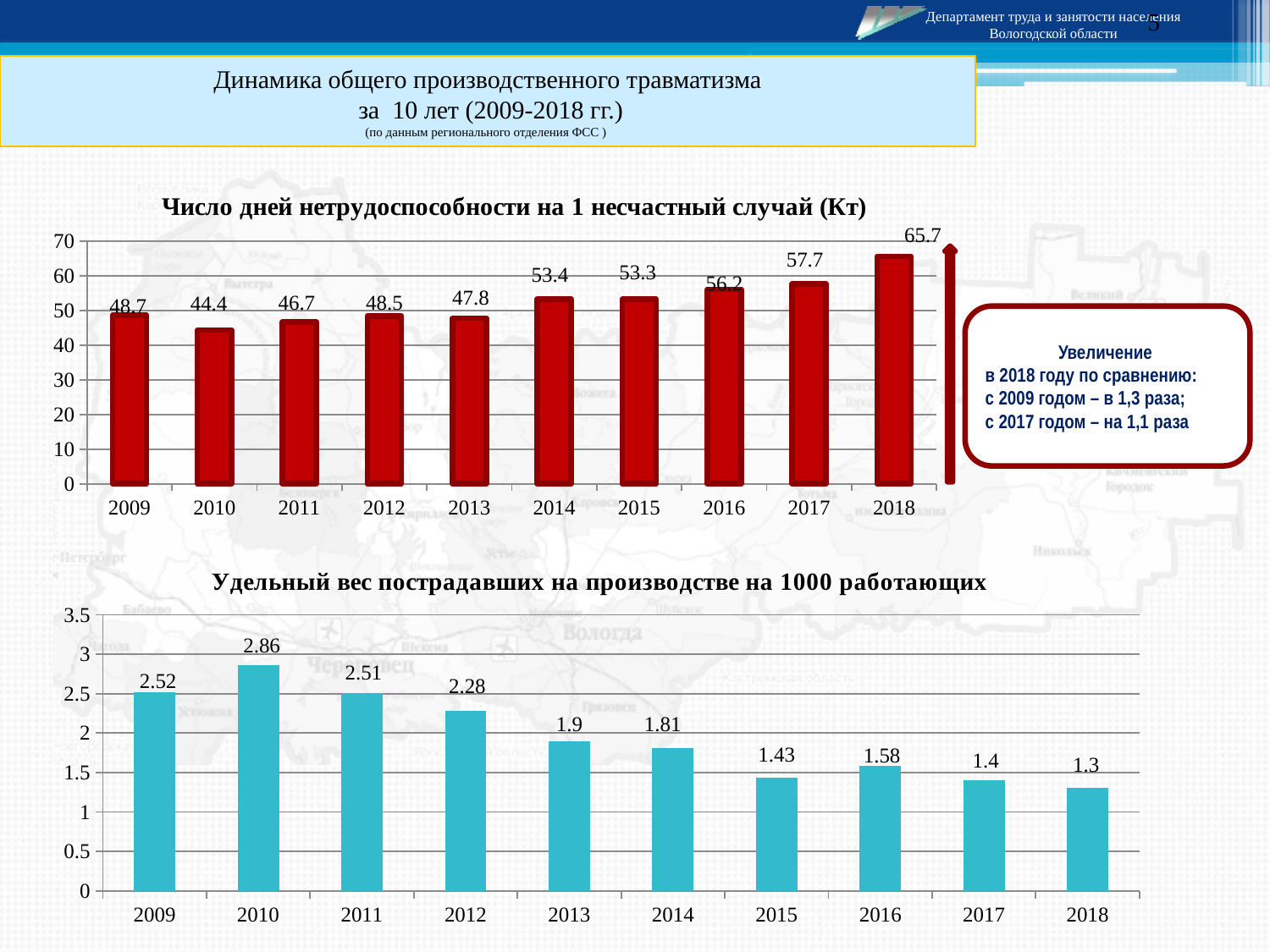
In the top chart (Число дней нетрудоспособности на 1 несчастный случай), what is the value for 2013? 47.8 In the bottom chart (Удельный вес пострадавших на производстве на 1000 работающих), what is the value for 2010? 2.86 In the top chart (Число дней нетрудоспособности на 1 несчастный случай), which year has the highest value? 2018 In the bottom chart (Удельный вес пострадавших на производстве на 1000 работающих), what is the value for 2015? 1.43 In the bottom chart (Удельный вес пострадавших на производстве на 1000 работающих), which year has the lowest value? 2018 In the top chart (Число дней нетрудоспособности на 1 несчастный случай), what is the difference between the values for 2018 and 2017? 8.0 In the bottom chart (Удельный вес пострадавших на производстве на 1000 работающих), which is larger, the value for 2016 or the value for 2017? 2016 In the bottom chart (Удельный вес пострадавших на производстве на 1000 работающих), do the values generally rise or fall from 2010 to 2018? fall What kind of chart is the bottom chart (Удельный вес пострадавших на производстве на 1000 работающих)? bar chart In the top chart (Число дней нетрудоспособности на 1 несчастный случай), which year has the lowest value? 2010 In the top chart (Число дней нетрудоспособности на 1 несчастный случай), how many years are shown on the x axis? 10 In the top chart (Число дней нетрудоспособности на 1 несчастный случай), what is the value for 2018? 65.7